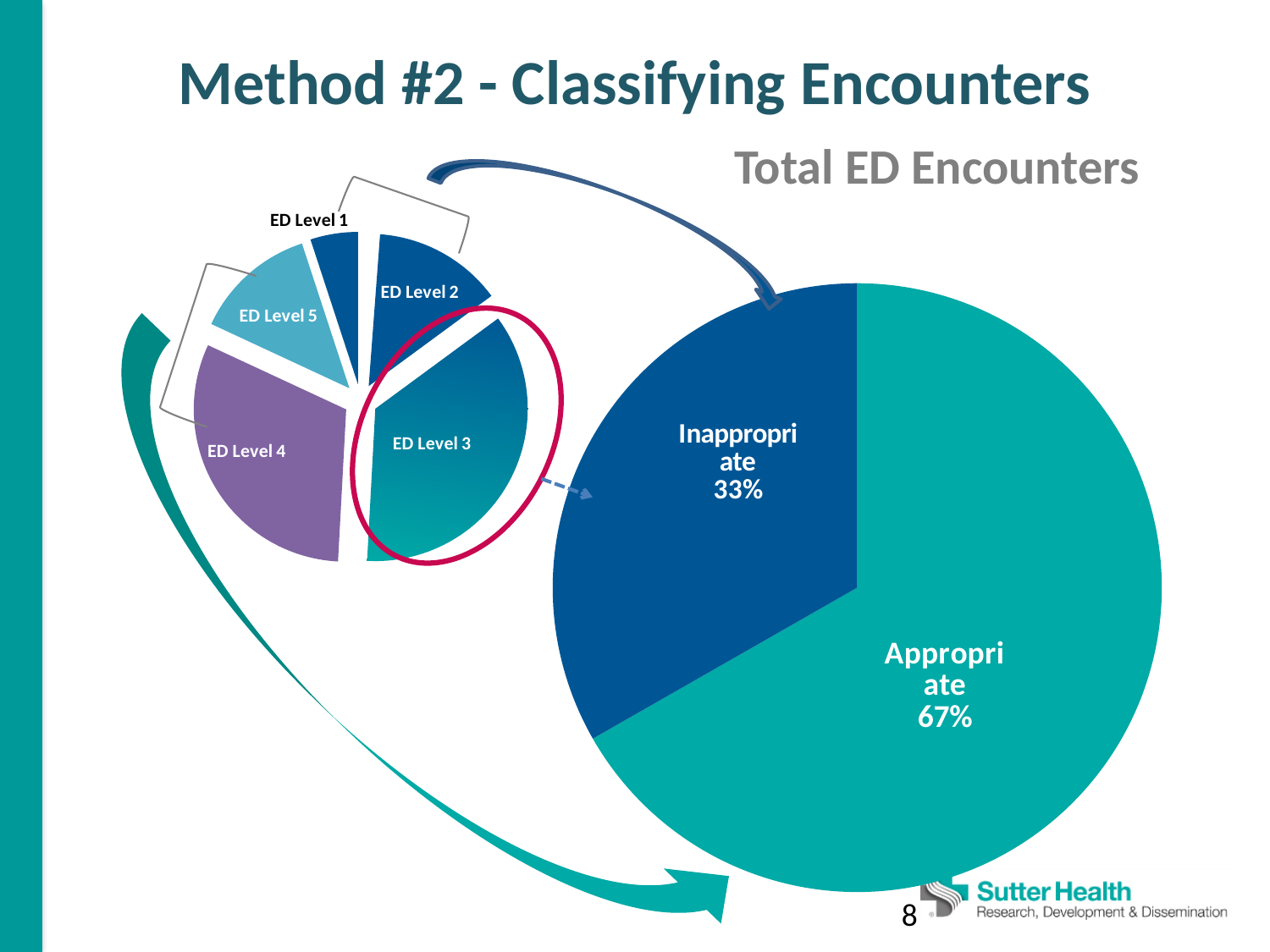
In the Total ED Encounters pie chart, what percentage of encounters is labelled Inappropriate? 33% How many slices does the Total ED Encounters pie chart have? 2 In the Total ED Encounters pie chart, which is larger, the Appropriate slice or the Inappropriate slice? Appropriate In the Total ED Encounters pie chart, by how many percentage points does Appropriate exceed Inappropriate? 34 percentage points In the smaller pie chart on the left of the slide, which ED Level slice is the smallest? ED Level 1 In the Total ED Encounters pie chart, what percentage of encounters is labelled Appropriate? 67% In the Total ED Encounters pie chart, which slice is the smallest? Inappropriate In the Total ED Encounters pie chart, which slice is the largest? Appropriate In the Total ED Encounters pie chart, what share of the pie does the Inappropriate slice represent? 33% What type of chart is the Total ED Encounters chart on the right of the slide? Pie chart What is the title of the pie chart on the right of the slide? Total ED Encounters